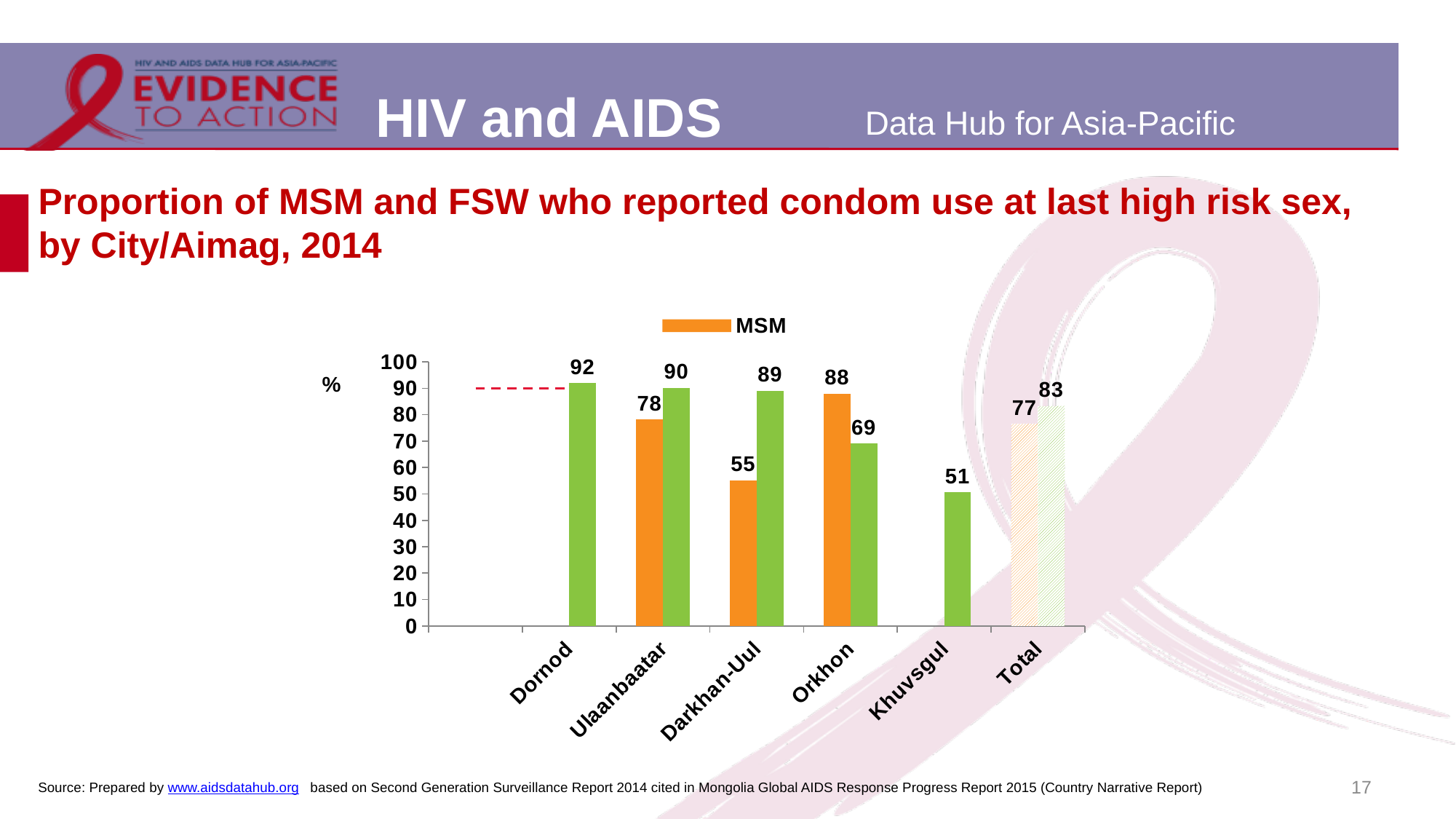
What is the MSM value for Ulaanbaatar? 78 What is the label on the y axis of the chart? % For Darkhan-Uul, which is larger: the MSM bar or the green bar? The green bar What kind of chart is shown on the slide? Bar chart For Total, what is the difference between the green bar value and the MSM value? 6 How many categories are shown on the x axis? 6 Which city/aimag has the highest MSM value? Orkhon What is the value of the green bar for Dornod? 92 What is the value of the green bar for Khuvsgul? 51 For Orkhon, what is the difference between the MSM value and the green bar value? 19 What is the MSM value for Orkhon? 88 Which city/aimag has the lowest green bar value? Khuvsgul